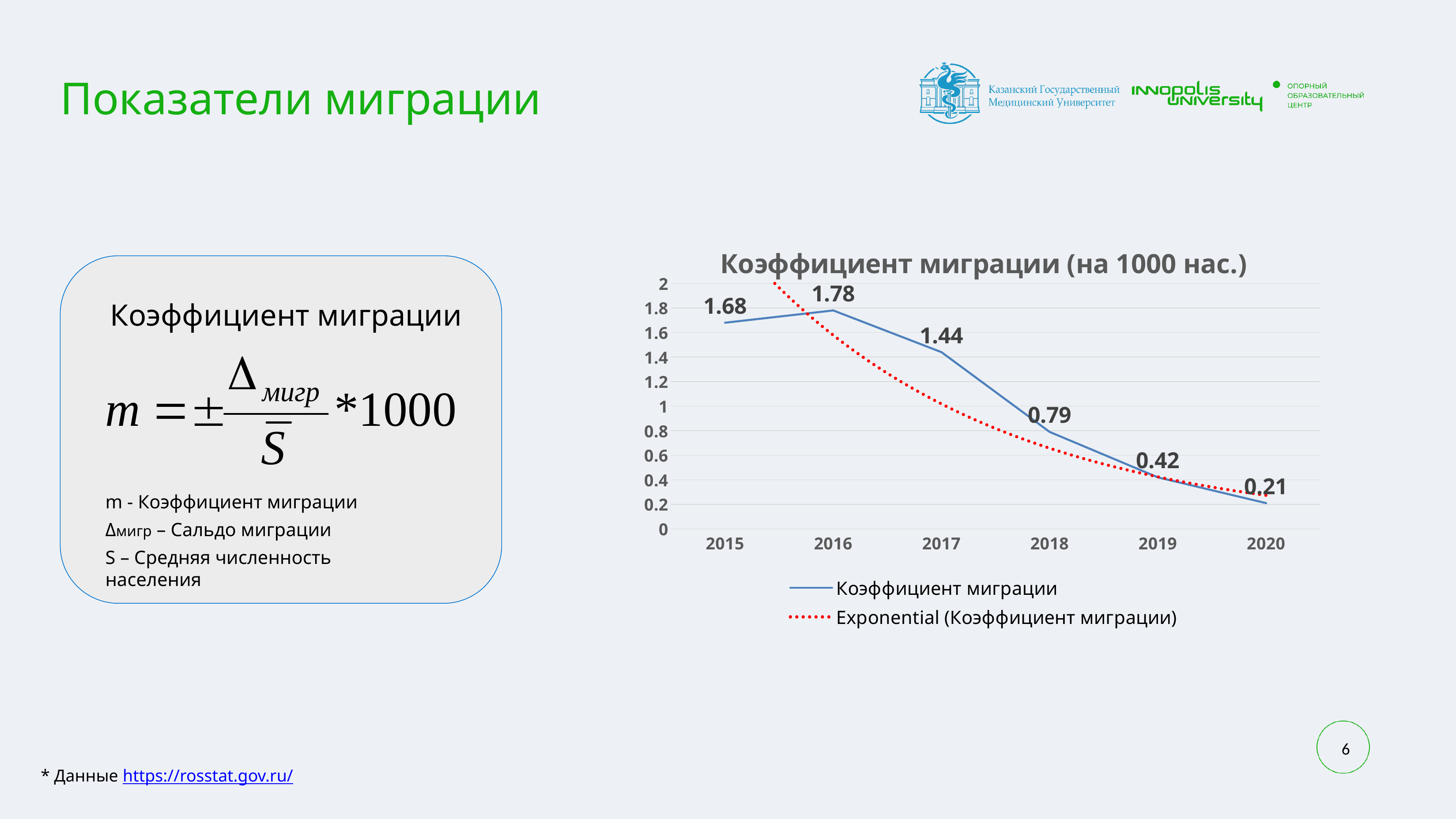
How many entries does the chart legend list? 2 What is the difference between the migration coefficient in 2016 and in 2017? 0.34 Which year has the highest migration coefficient? 2016 Is the migration coefficient for 2018 greater or less than 1? less What is the migration coefficient value for 2020? 0.21 Which year has the lowest migration coefficient? 2020 What is the migration coefficient value for 2016? 1.78 What kind of chart is shown on the slide? line chart Which year has a larger migration coefficient, 2017 or 2019? 2017 How many years are plotted on the x axis of the chart? 6 What is the difference between the migration coefficient in 2015 and in 2020? 1.47 What is the migration coefficient value for 2018? 0.79